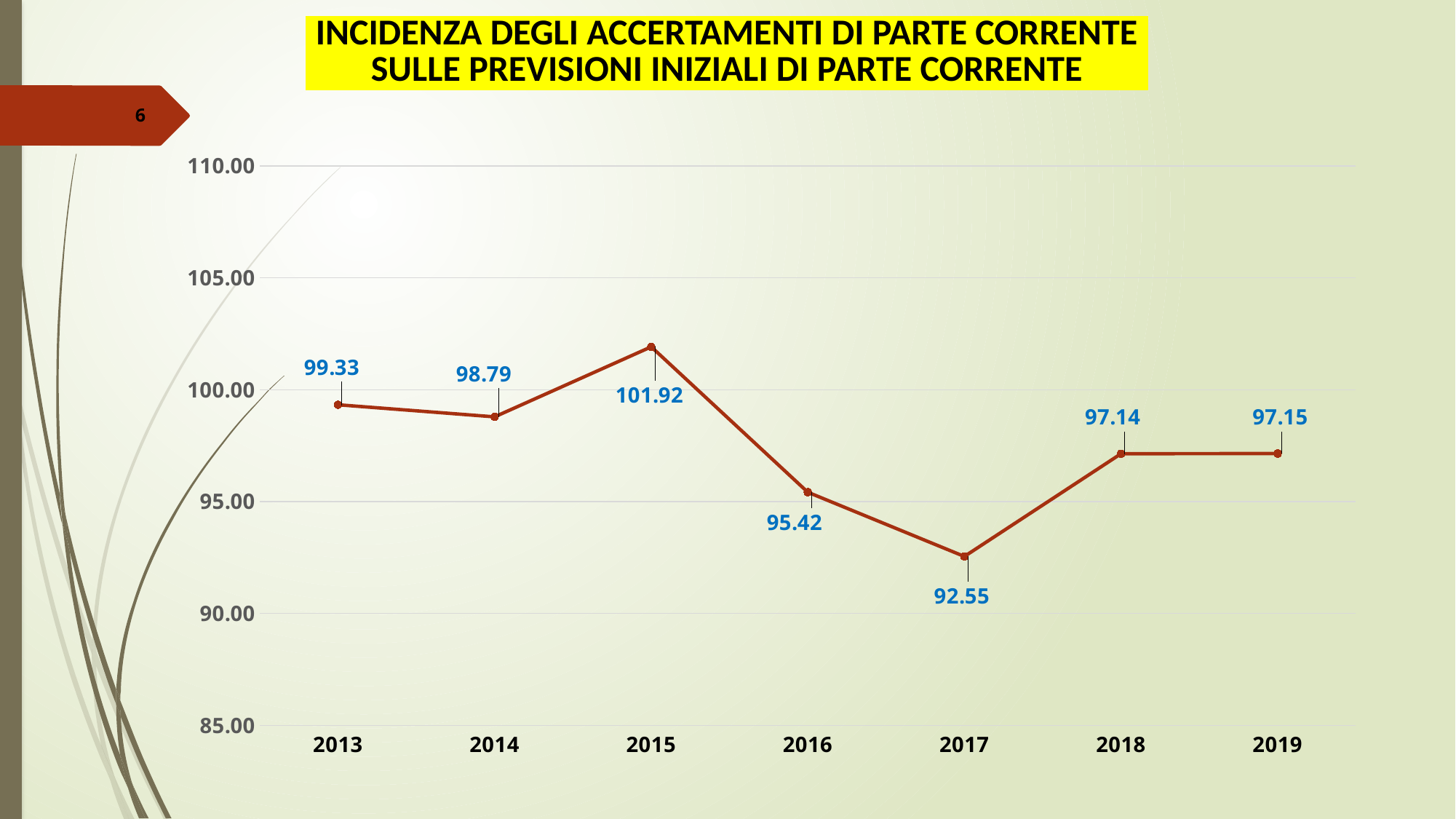
What is the value for 2013? 99.33 Which year has the highest value? 2015 Which is larger, the value for 2016 or the value for 2018? 2018 What is the difference between the values for 2015 and 2017? 9.37 Which year has the lowest value? 2017 How many years are plotted on the chart? 7 What kind of chart is shown on the slide? line chart Do the values rise or fall from 2015 to 2017? fall Is the value for 2017 greater or less than 95.00? less What is the value for 2017? 92.55 What is the value for 2015? 101.92 What is the difference between the values for 2013 and 2014? 0.54